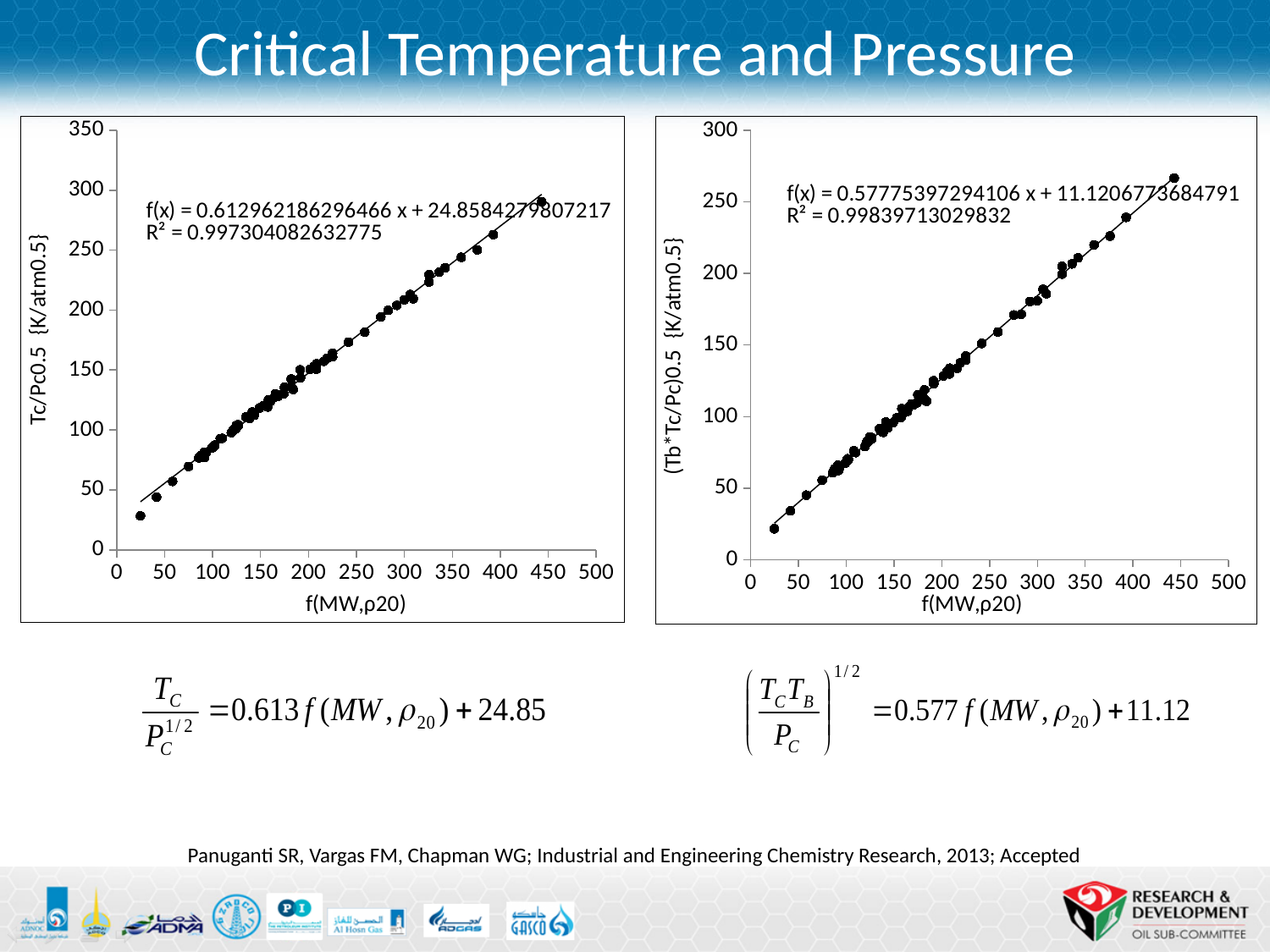
In the right chart, is the value of the rightmost data point (near f(MW,ρ20) = 450) greater or less than 250? greater What is the trendline equation shown on the right chart? f(x) = 0.57775397294106 x + 11.1206773684791 In the left chart, do the Tc/Pc0.5 values rise or fall as f(MW,ρ20) increases? rise In the left chart, is the value of the leftmost data point (near f(MW,ρ20) = 25) greater or less than 50? less In the right chart, do the (Tb*Tc/Pc)0.5 values rise or fall as f(MW,ρ20) increases? rise What R² value is shown on the left chart? 0.997304082632775 In the right chart, is the value of the leftmost data point (near f(MW,ρ20) = 25) greater or less than 50? less What kind of chart is the left chart (Tc/Pc0.5 vs f(MW,ρ20))? scatter chart What kind of chart is the right chart ((Tb*Tc/Pc)0.5 vs f(MW,ρ20))? scatter chart